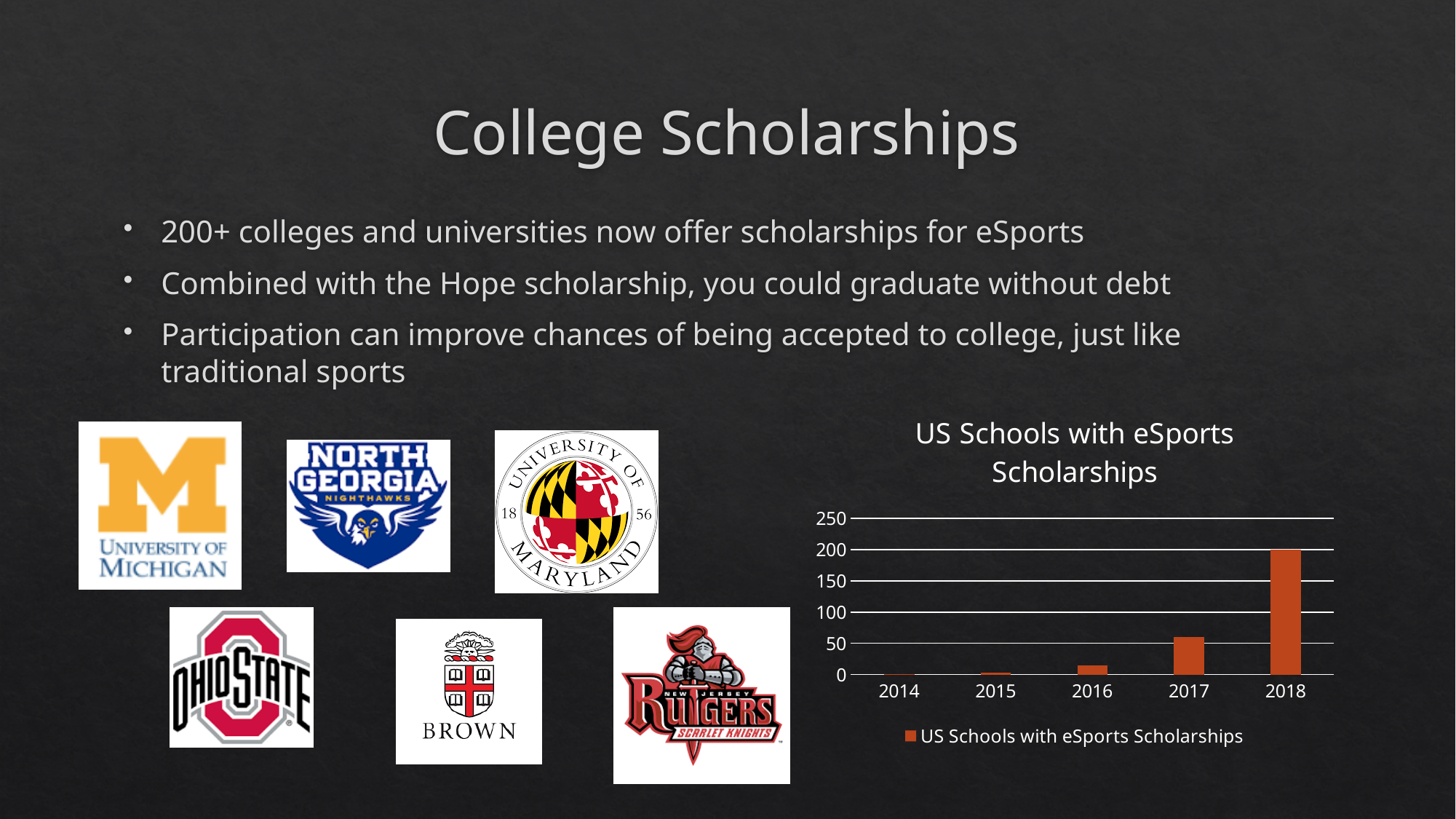
Is the value for 2017 greater or less than 100? less How many series does the chart's legend list? 1 Is the value for 2017 greater or less than 50? greater How many years are shown on the x axis of the chart? 5 Do the values rise or fall from 2014 to 2018? rise What type of chart is shown on the slide? bar chart Which year has the highest number of US schools with eSports scholarships? 2018 Is the value for 2016 greater or less than 50? less What is the title of the chart? US Schools with eSports Scholarships Which is larger, the value for 2017 or the value for 2016? 2017 What is the highest value shown on the chart's y axis? 250